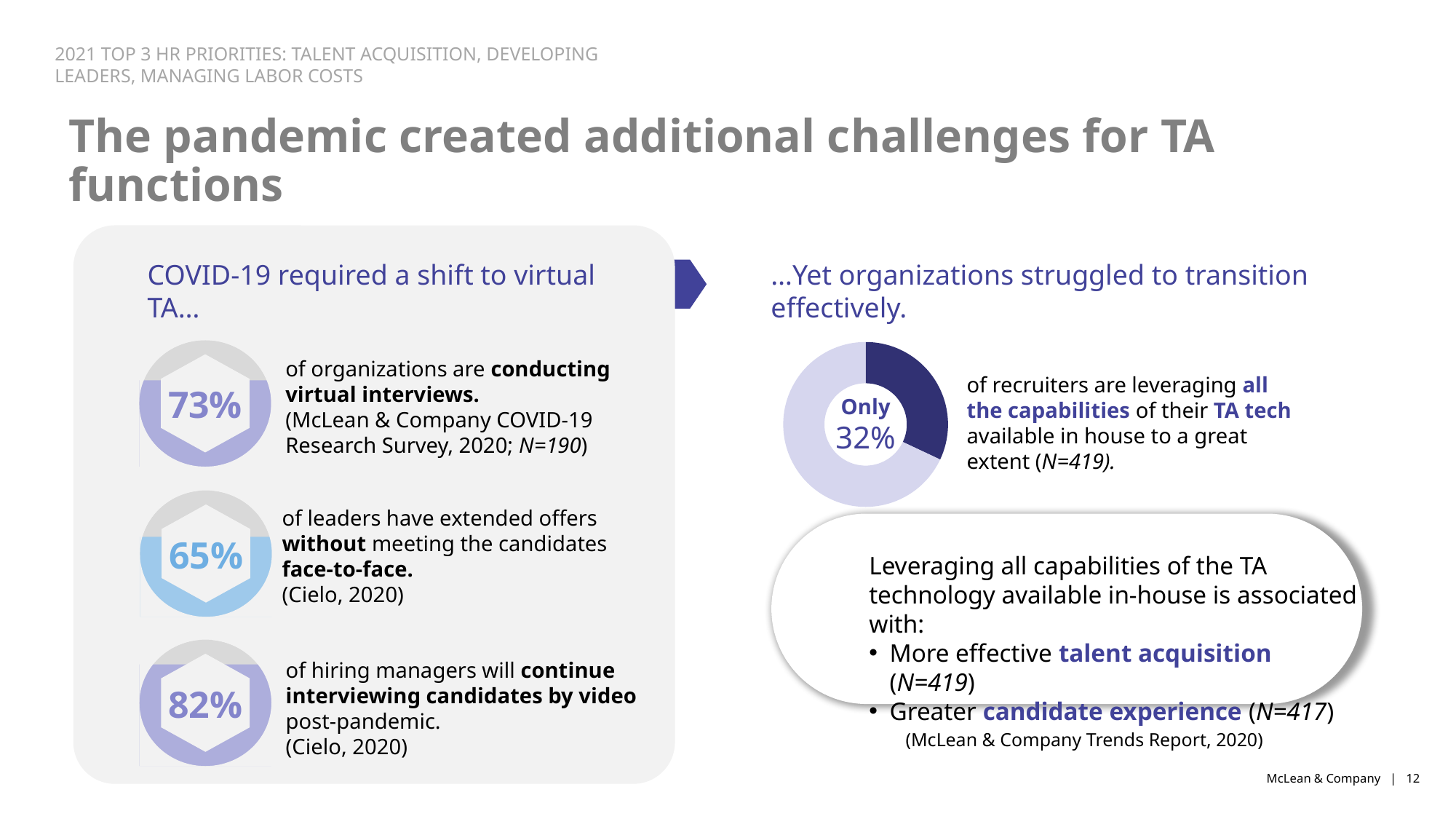
In the left panel of gauge graphics, what percentage of hiring managers will continue interviewing candidates by video post-pandemic? 82% Among the three gauge graphics in the left panel, which statistic has the highest value? Hiring managers who will continue interviewing candidates by video post-pandemic (82%) Among the three gauge graphics in the left panel, which statistic has the lowest value? Leaders who have extended offers without meeting the candidates face-to-face (65%) In the left panel of gauge graphics, what percentage of leaders have extended offers without meeting the candidates face-to-face? 65% What kind of chart is shown on the right side of the slide next to the text about recruiters leveraging TA tech capabilities? Donut (pie) chart How many slices does the donut chart on the right have? 2 In the donut chart on the right, what percentage of recruiters are leveraging all the capabilities of their TA tech available in house to a great extent? 32% In the left panel of gauge graphics, what is the difference between the 82% value and the 73% value? 9 percentage points In the donut chart on the right, which slice is larger: the dark purple slice or the light lavender slice? The light lavender slice In the donut chart on the right, is the value shown greater or less than 50%? less In the left panel of gauge graphics, what percentage of organizations are conducting virtual interviews? 73% What word is printed above the 32% value in the centre of the donut chart on the right? Only